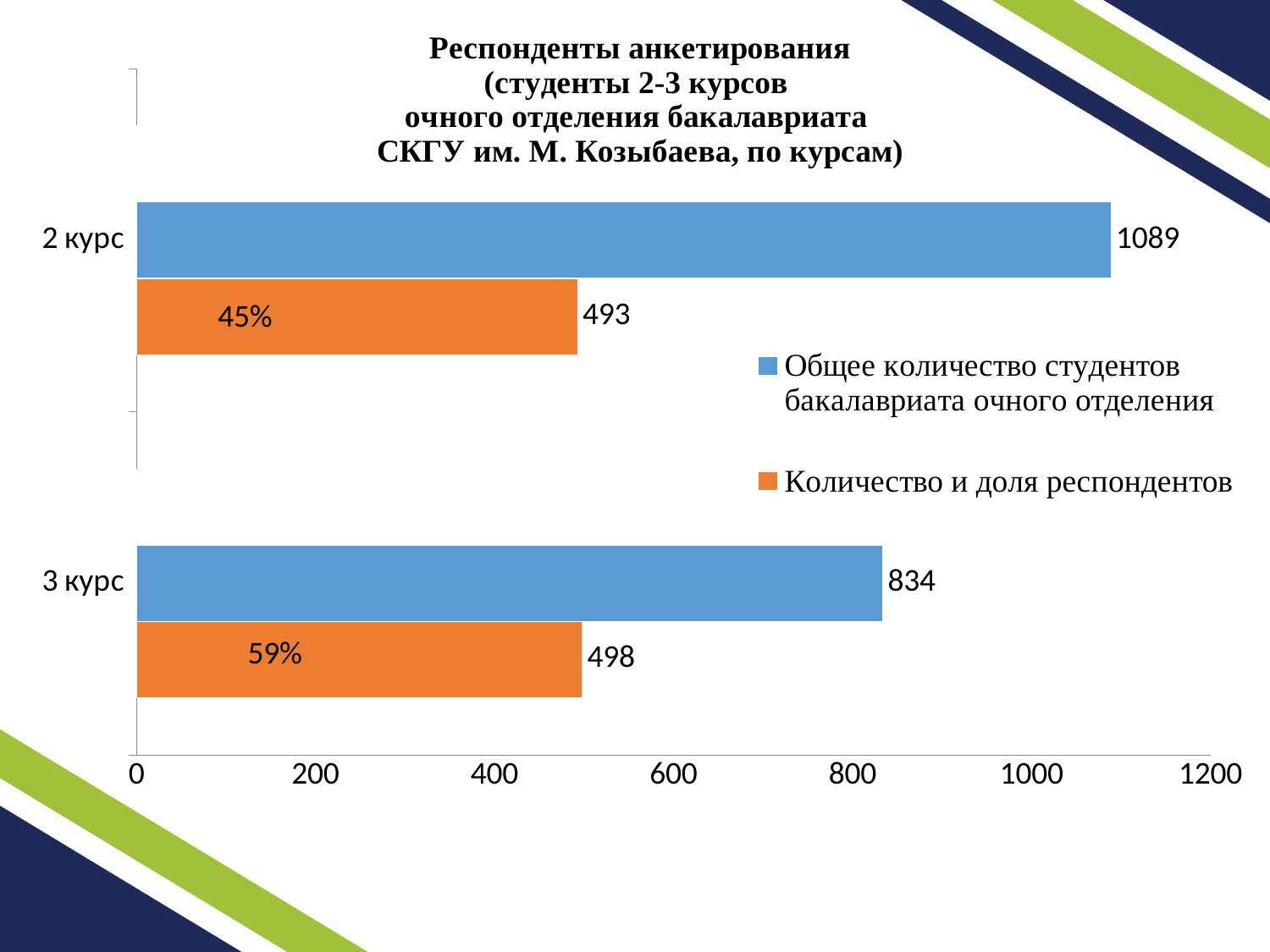
Which course has the higher total number of full-time bachelor's students? 2 курс How many courses (categories) are shown on the chart? 2 Is the total number of students for 3 курс greater or less than 800? greater What is the difference between the total number of students and the number of respondents for 3 курс? 336 Which is larger: the number of respondents for 2 курс or for 3 курс? 3 курс What is the difference between the total number of students for 2 курс and 3 курс? 255 What is the number of respondents (Количество и доля респондентов) for 3 курс? 498 What kind of chart is shown on the slide? Bar chart What share of respondents is shown inside the orange bar for 2 курс? 45% What share of respondents is shown inside the orange bar for 3 курс? 59% What is the total number of full-time bachelor's students (Общее количество студентов бакалавриата очного отделения) for 2 курс? 1089 How many series does the legend list? 2